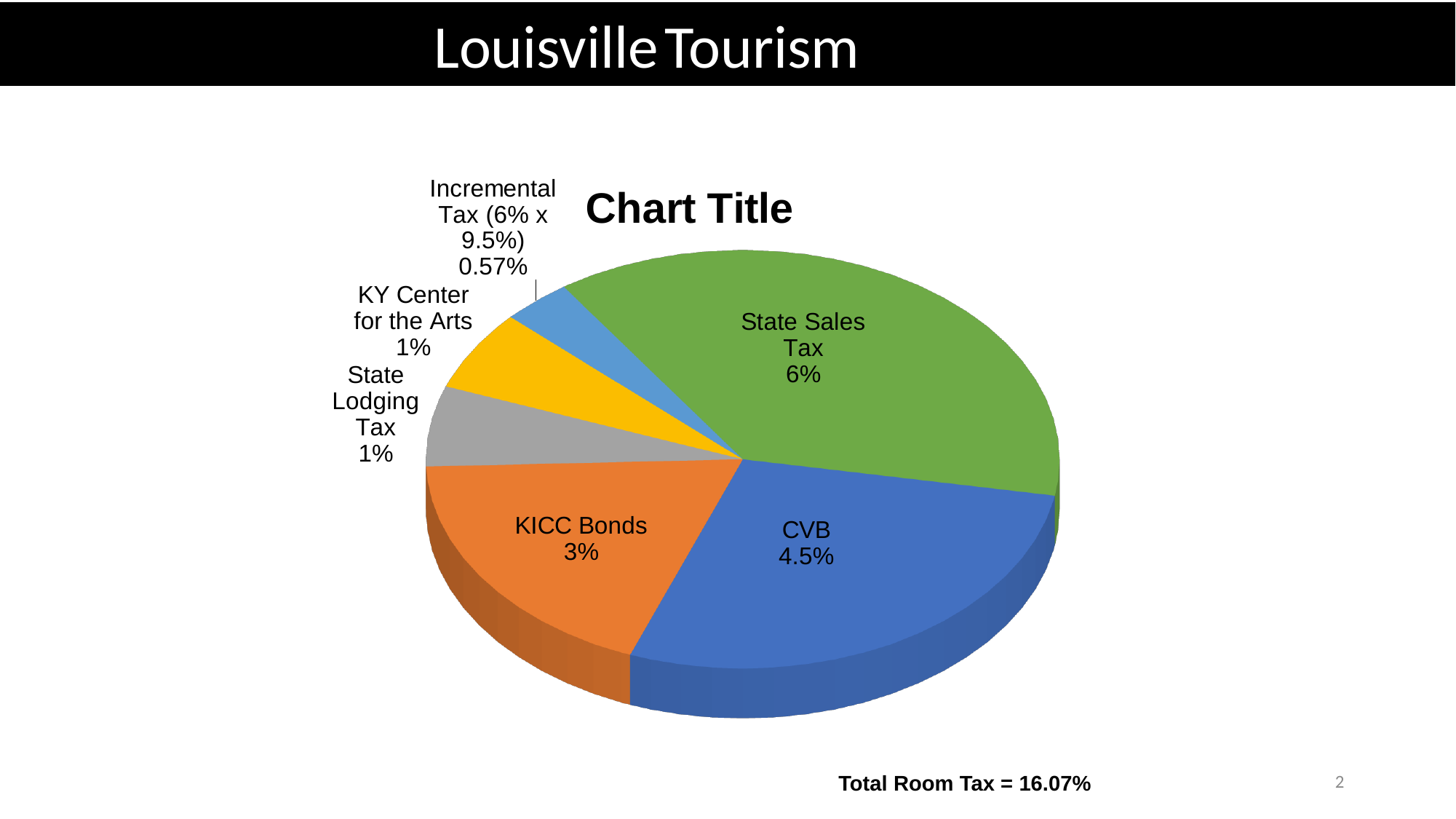
What value is shown for the CVB slice? 4.5% What value is shown for the State Sales Tax slice? 6% What value is shown for the State Lodging Tax slice? 1% What is the title shown above the chart? Chart Title Which slice has the smallest value? Incremental Tax (6% x 9.5%) Which slice has the largest value? State Sales Tax What kind of chart is shown on the slide? Pie chart What value is shown for the Incremental Tax (6% x 9.5%) slice? 0.57% What value is shown for the KICC Bonds slice? 3% What is the difference between the State Sales Tax value and the CVB value? 1.5% Which is larger, the CVB value or the KICC Bonds value? CVB How many slices does the pie chart have? 6